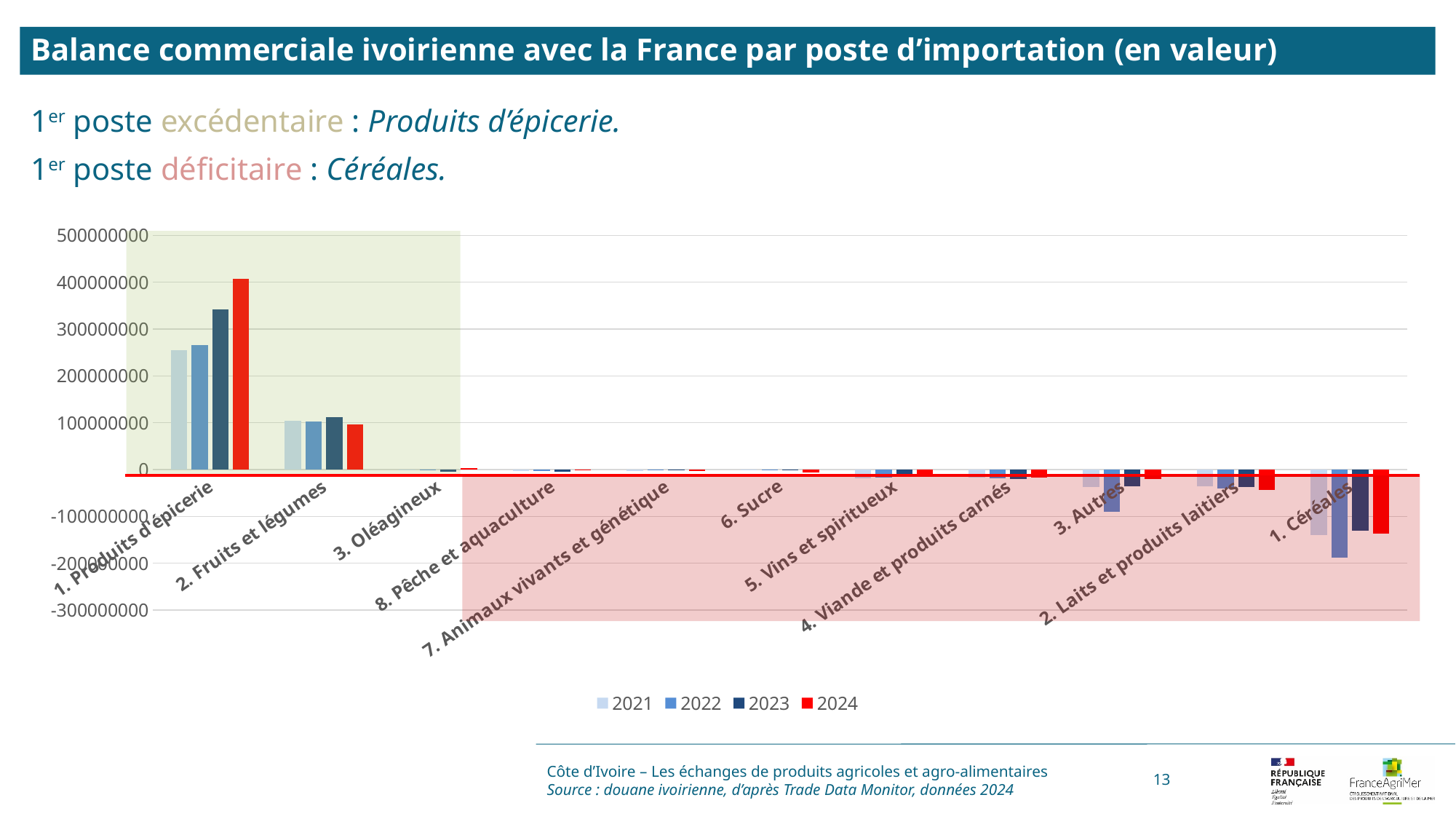
Is the 2024 value for 2. Fruits et légumes greater or less than 200000000? less Is the 2024 value for 1. Produits d'épicerie greater or less than 300000000? greater Is the 2021 value for 1. Produits d'épicerie greater or less than 200000000? greater Which years are listed in the legend? 2021, 2022, 2023, 2024 Do the values for 1. Produits d'épicerie rise or fall from 2021 to 2024? rise How many import categories are shown on the x axis? 11 Which category has the lowest (most negative) value in 2022? 1. Céréales For 1. Produits d'épicerie, which is larger: the 2024 value or the 2021 value? 2024 Which category has the highest value in 2024? 1. Produits d'épicerie What kind of chart is shown on the slide? bar chart How many series does the legend list? 4